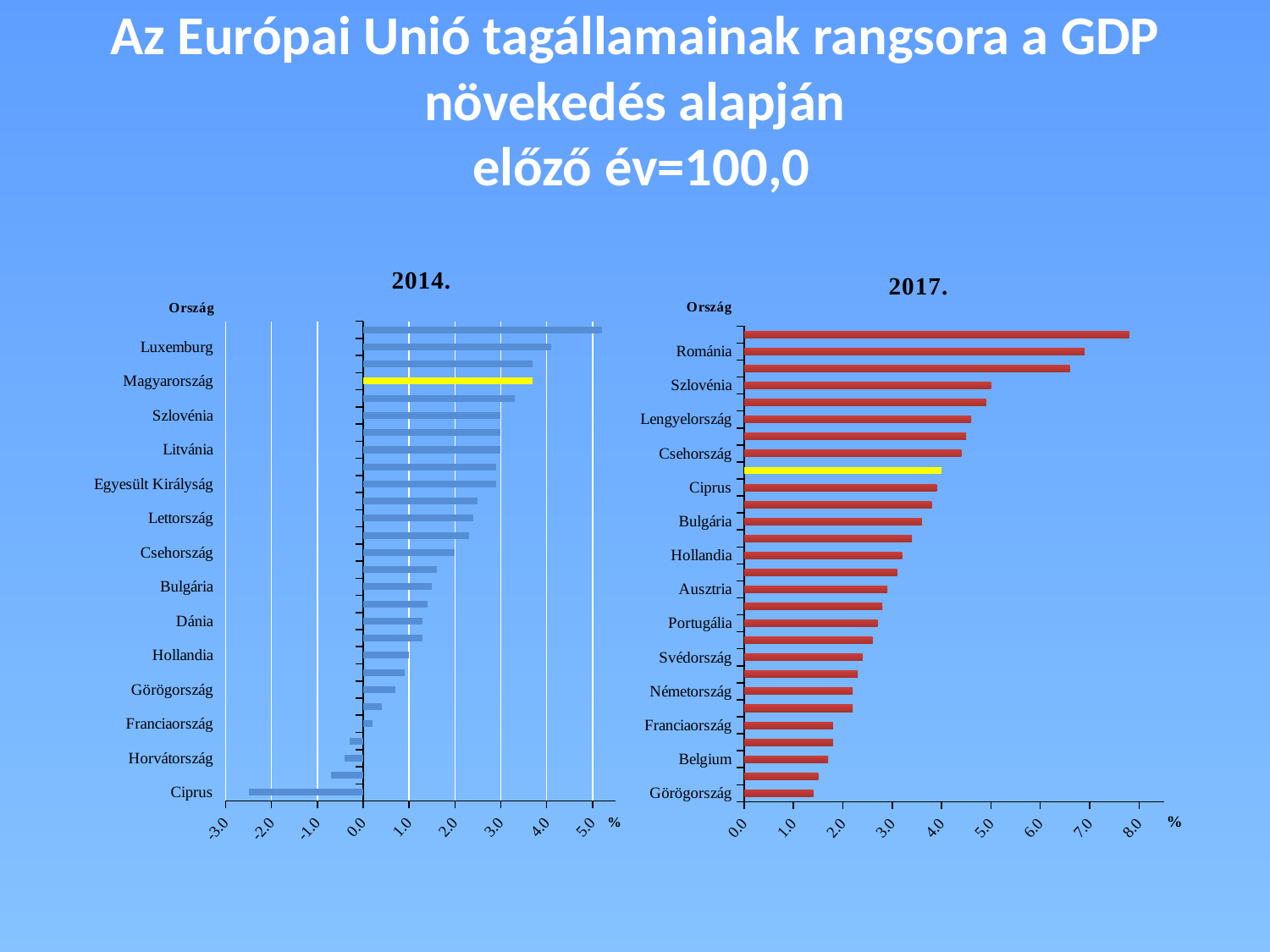
In the 2017. chart, is the value for Belgium greater or less than 2.0? less In the 2014. chart, which country's bar is highlighted in yellow? Magyarország In the 2014. chart, which labelled country has the lowest value? Ciprus In the 2017. chart, is the value for Lengyelország greater or less than 4.0? greater In the 2014. chart, is the value for Görögország greater or less than 1.0? less How many charts are shown on the slide? 2 In the 2017. chart, which is larger, the value for Románia or the value for Görögország? Románia What kind of chart is the 2014. chart? bar chart In the 2017. chart, which labelled country has the lowest value? Görögország